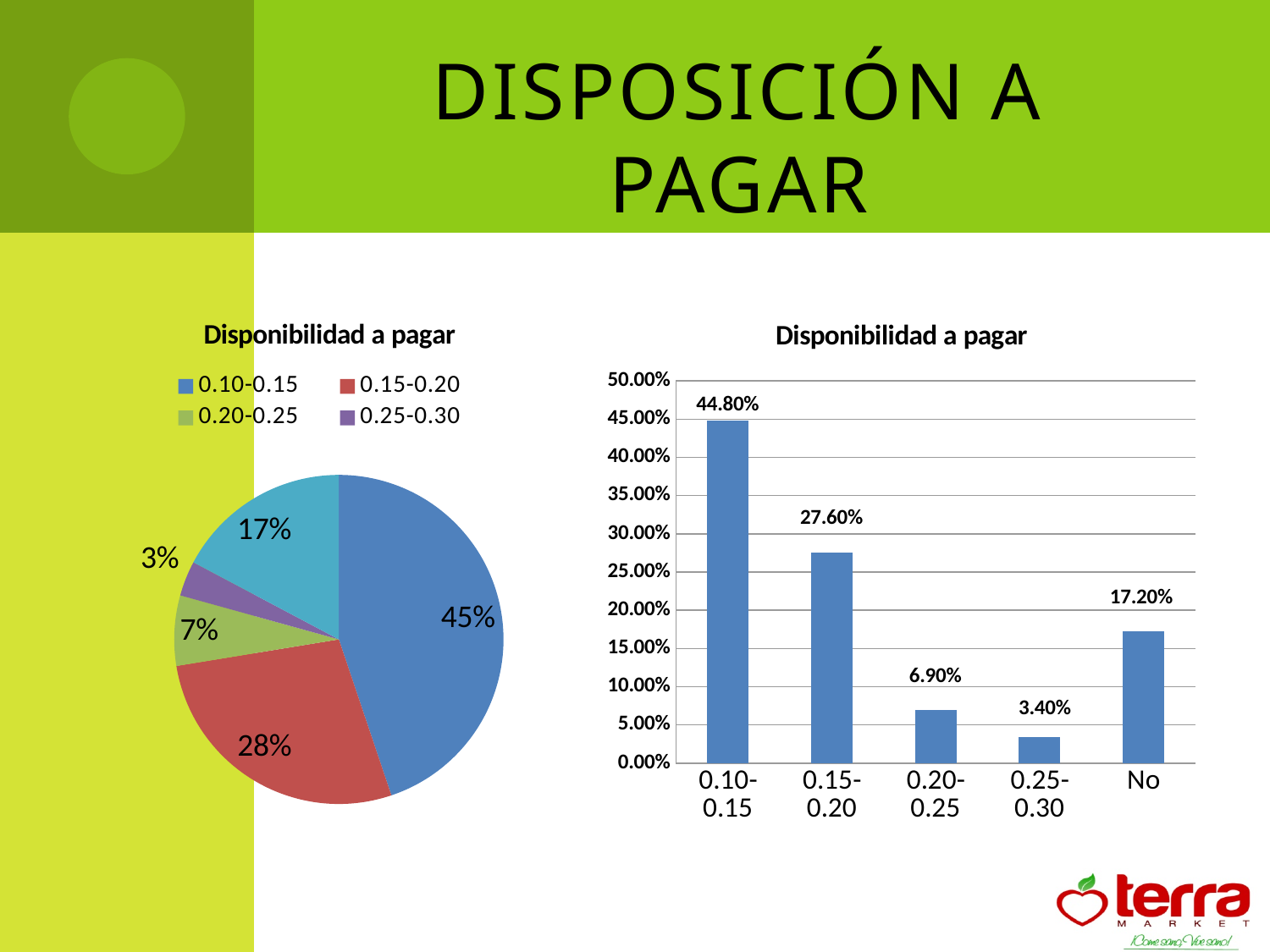
On the bar chart on the right, what is the value for the 0.10-0.15 category? 44.80% On the bar chart on the right, which category has the highest value? 0.10-0.15 On the pie chart on the left, what share does the 0.25-0.30 slice have? 3% On the bar chart on the right, what is the value for the No category? 17.20% On the pie chart on the left, what share does the 0.15-0.20 slice have? 28% On the bar chart on the right, which category has the lowest value? 0.25-0.30 What kind of chart is the chart on the right side of the slide? Bar chart On the pie chart on the left, how many entries does the legend list? 4 On the bar chart on the right, which is larger: the value for No or the value for 0.20-0.25? No On the bar chart on the right, what is the difference between the values for 0.15-0.20 and 0.20-0.25? 20.70% What is the title of the pie chart on the left? Disponibilidad a pagar On the bar chart on the right, how many categories are shown on the x axis? 5